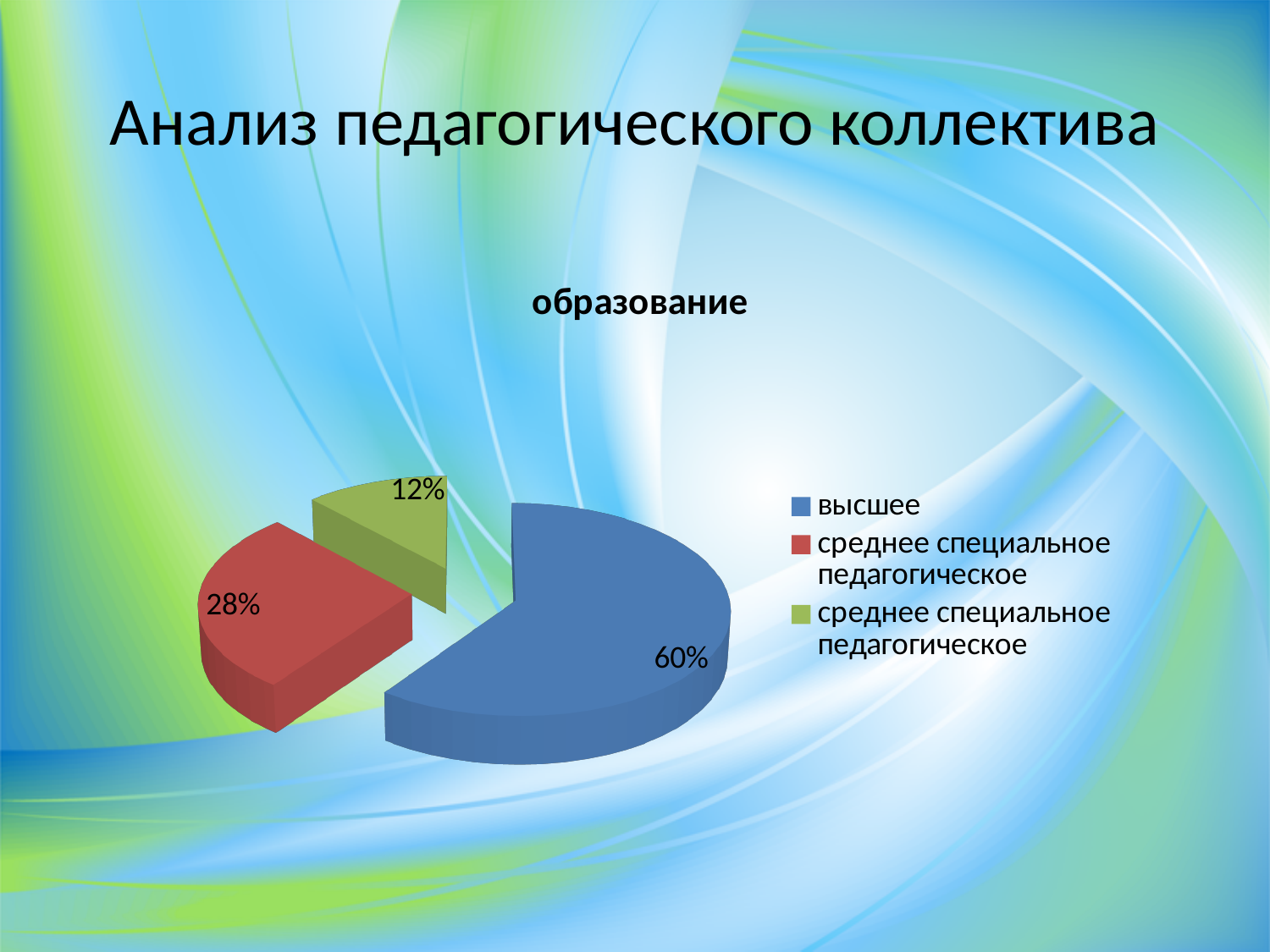
How many slices does the pie chart have? 3 Which category has the largest slice of the pie? высшее What kind of chart is shown on the slide? pie chart Which is larger, the "высшее" slice or the red slice? высшее What value is labelled on the red slice of the pie? 28% What is the title of the chart? образование What value is labelled on the green slice of the pie? 12% What is the difference between the "высшее" slice and the red slice? 32% What share of the pie does the "высшее" slice represent? 60% What is the smallest value shown on the pie chart? 12% What is the difference between the red slice and the green slice? 16% How many entries does the legend list? 3